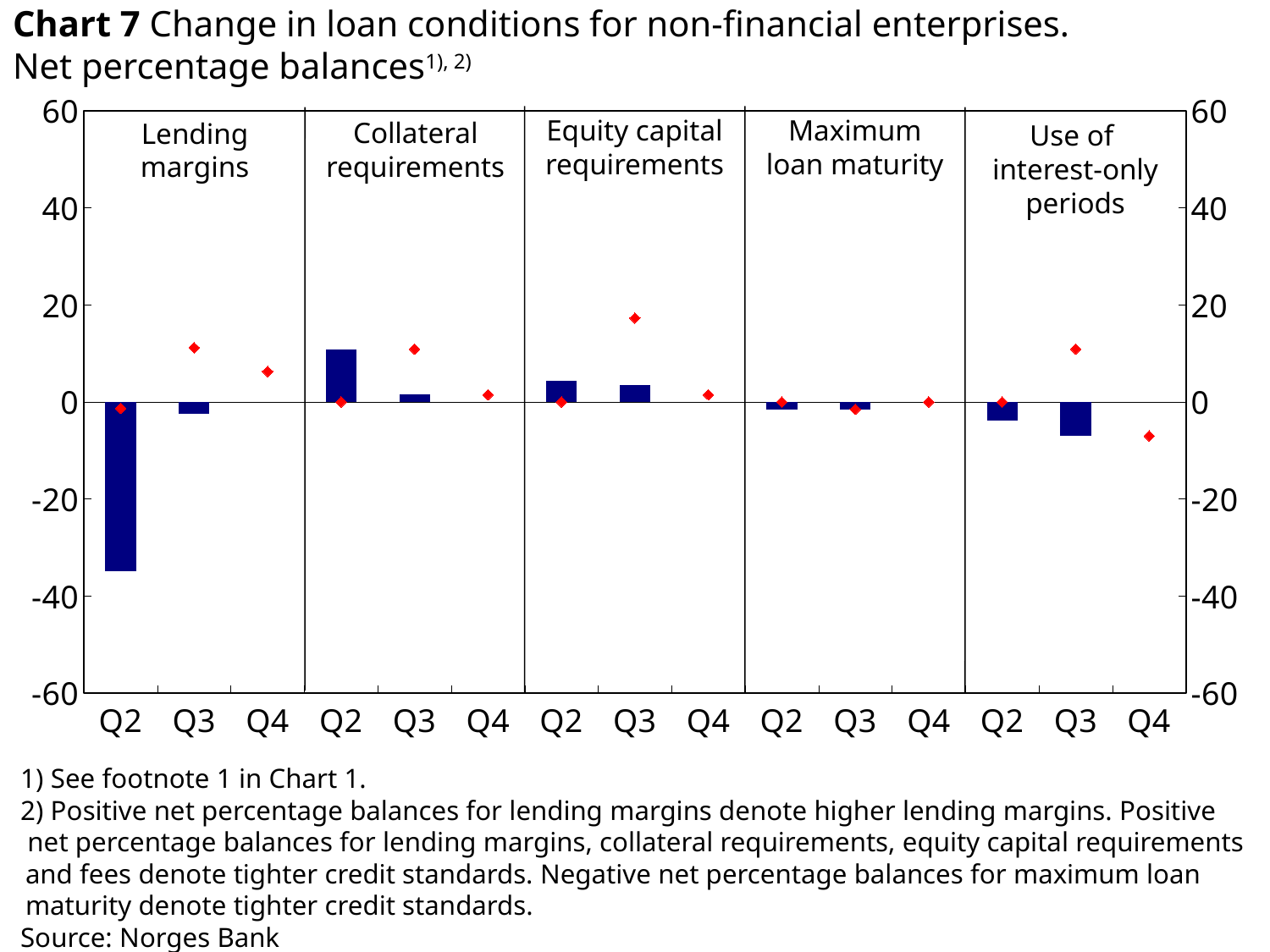
Which panel and quarter has the highest bar in Chart 7? Collateral requirements, Q2 In the Use of interest-only periods panel, which bar is lower, Q2 or Q3? Q3 In the Lending margins panel, is the Q2 bar greater or less than -40? greater Which is larger: the Q2 bar for Collateral requirements or the Q2 bar for Equity capital requirements? Collateral requirements What kind of chart is Chart 7? bar chart In the Equity capital requirements panel, is the Q3 red diamond marker greater or less than 10? greater How many loan-condition panels does Chart 7 show? 5 Which panel and quarter has the lowest bar in Chart 7? Lending margins, Q2 In the Lending margins panel, is the Q2 bar greater or less than -20? less What are the minimum and maximum values shown on the vertical axis of Chart 7? -60 and 60 How many quarters are shown in each panel of Chart 7? 3